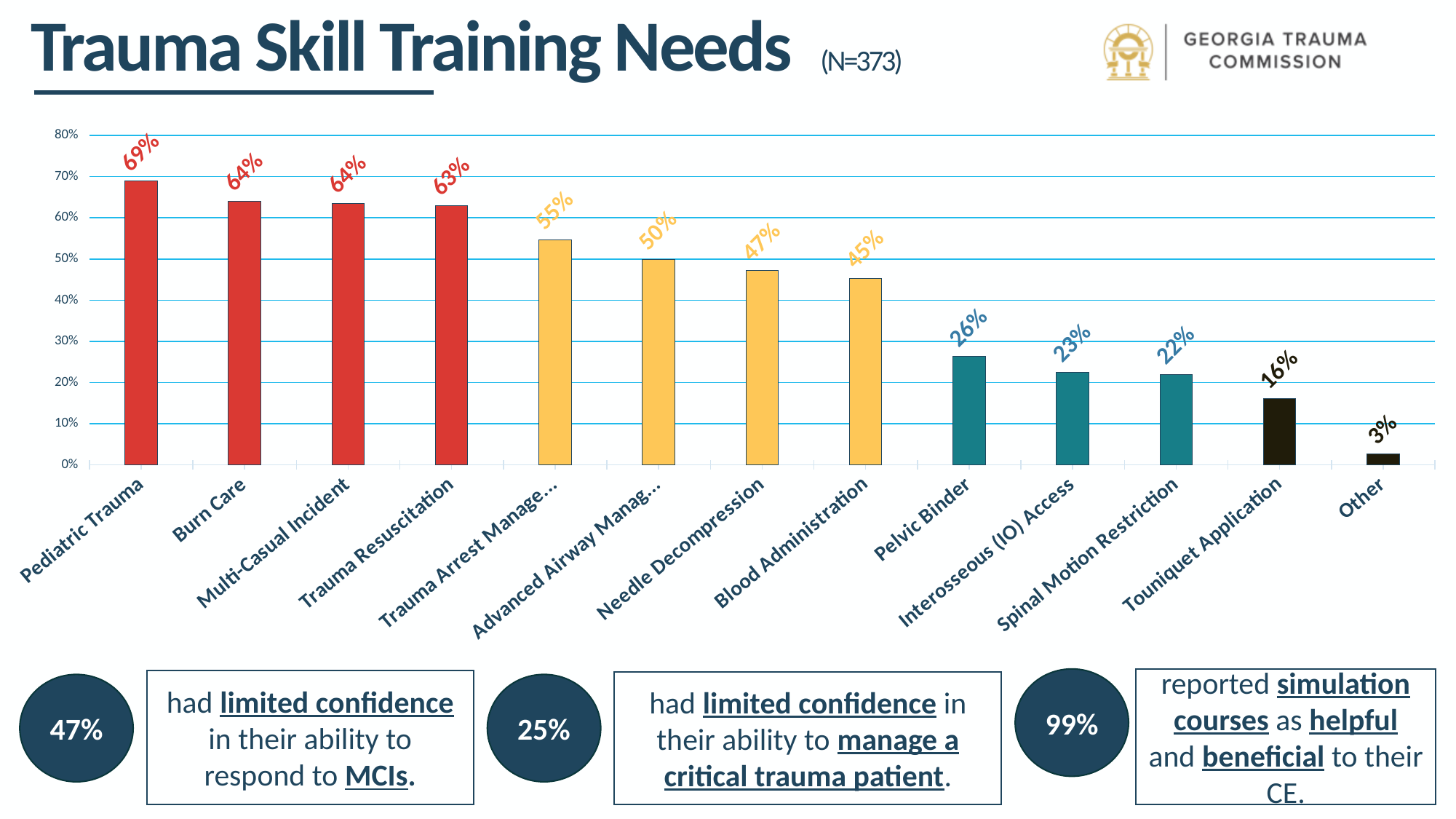
Do the values rise or fall from left to right along the x axis? fall What is the value for Needle Decompression? 47% What kind of chart is shown on the slide? bar chart What is the value for Pediatric Trauma? 69% Which category has the highest value? Pediatric Trauma Is the value for Interosseous (IO) Access greater or less than 30%? less Which category has the lowest value? Other What is the difference between the values for Pediatric Trauma and Tourniquet Application? 53% Which is larger, the value for Burn Care or the value for Advanced Airway Management? Burn Care How many categories are shown in the chart? 13 What is the value for Spinal Motion Restriction? 22% What is the difference between the values for Blood Administration and Pelvic Binder? 19%